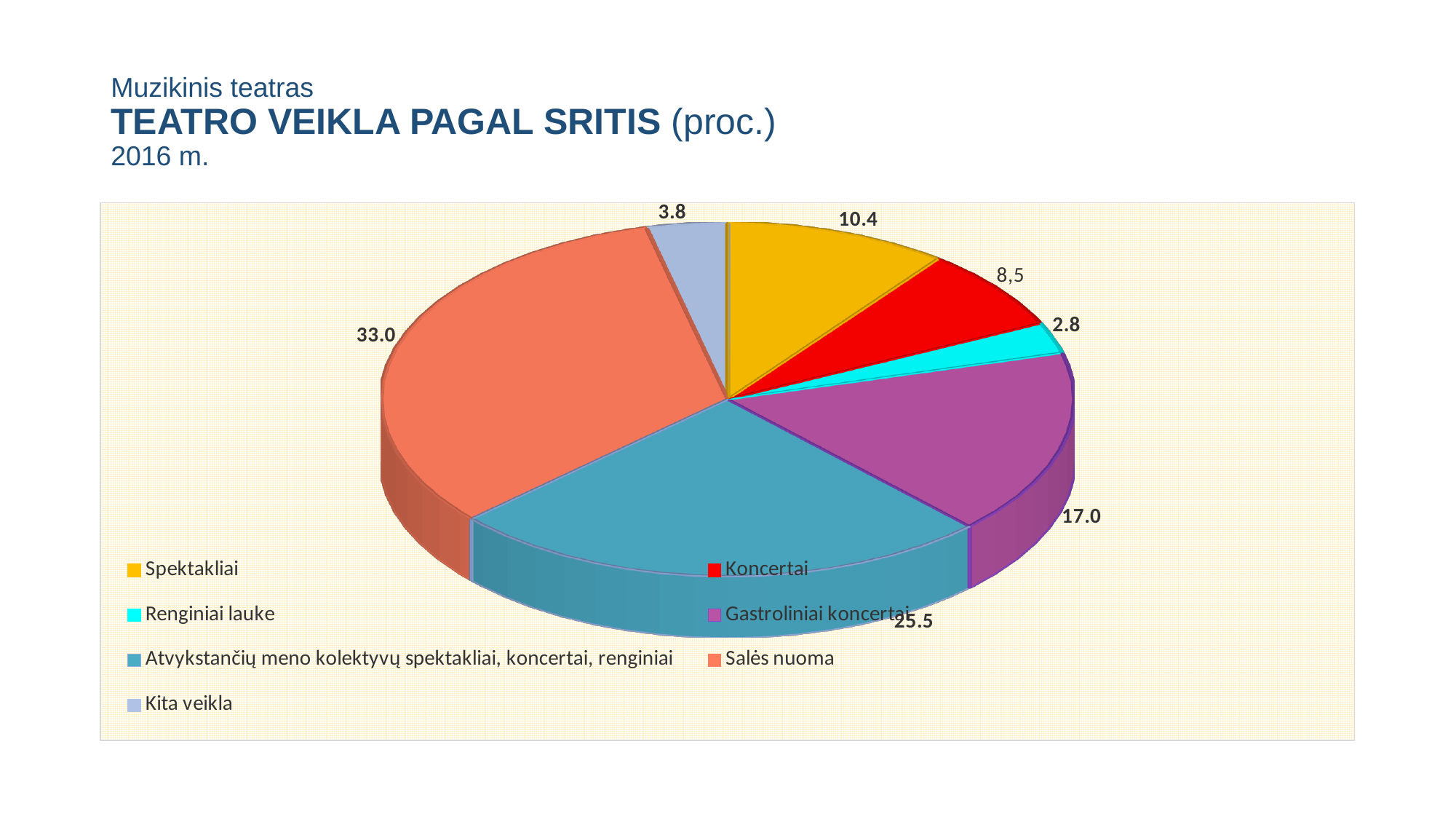
Which is larger, the value for Spektakliai or the value for Kita veikla? Spektakliai What is the value for Renginiai lauke? 2.8 What is the value for Kita veikla? 3.8 What is the value for Gastroliniai koncertai? 17.0 What is the difference between the values for Salės nuoma and Gastroliniai koncertai? 16.0 Which category has the largest share of the pie? Salės nuoma How many categories does the pie chart have? 7 What colour is the slice for Atvykstančių meno kolektyvų spektakliai, koncertai, renginiai? teal Which category has the smallest share of the pie? Renginiai lauke What type of chart is shown on the slide? pie chart What is the value for Spektakliai? 10.4 What is the value for Salės nuoma? 33.0